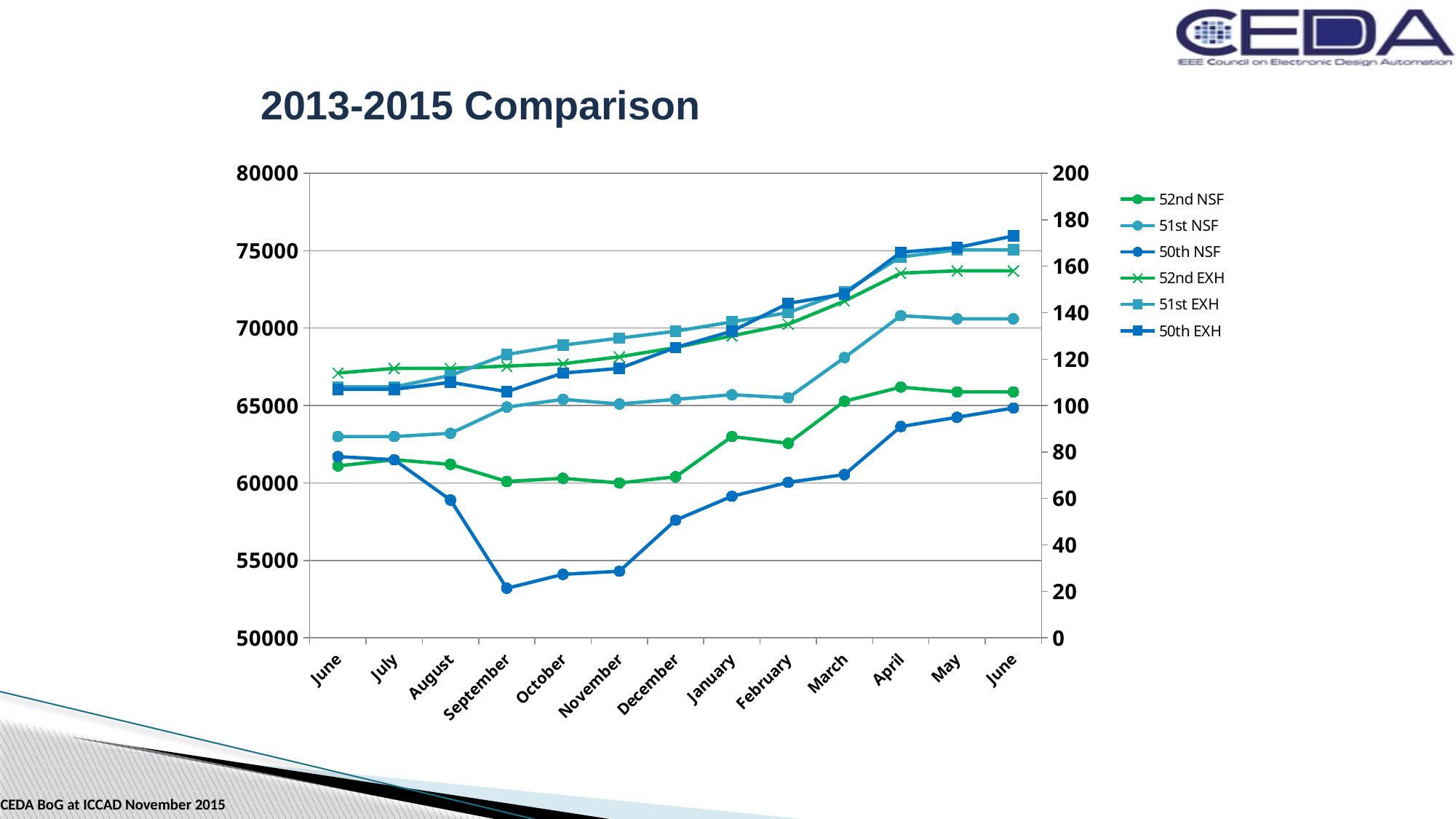
Is the value for 52nd EXH in the final June greater or less than 140 on the right axis? greater What kind of chart is shown on the slide? line chart What is the title of the chart? 2013-2015 Comparison Which series is listed first in the legend? 52nd NSF How many months are plotted along the x axis? 13 Does the 50th EXH line generally rise or fall from the first June to the last June? rise Is the value for 50th NSF in September greater or less than 55000 on the left axis? less In September, which is larger: 52nd NSF or 50th NSF? 52nd NSF In which month does the 50th NSF line reach its lowest point? September How many series does the legend list? 6 In which month does the 50th EXH line reach its highest point? June (the final month) In April, which is larger: 51st NSF or 52nd NSF? 51st NSF